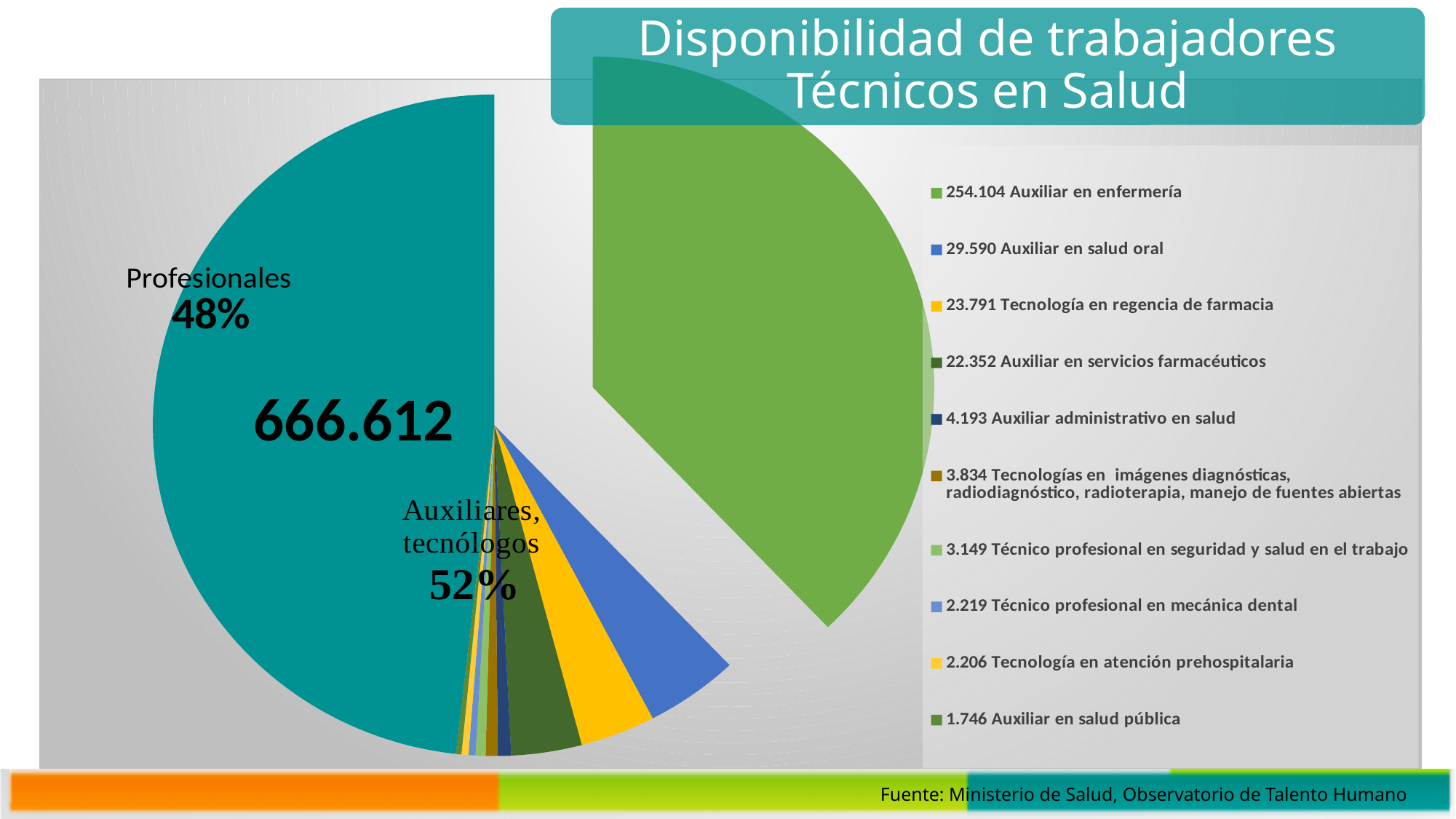
What total figure is printed in the centre of the pie chart? 666.612 How many categories does the legend list? 10 What value is listed in the legend for Auxiliar administrativo en salud? 4.193 What percentage of the pie is labelled Profesionales? 48% Which legend category has the highest value? Auxiliar en enfermería What value is listed in the legend for Auxiliar en salud oral? 29.590 What percentage of the pie is labelled Auxiliares, tecnólogos? 52% What is the difference between the values for Auxiliar en enfermería and Auxiliar en salud oral? 224.514 What kind of chart is shown on the slide? pie chart What is the title of the chart? Disponibilidad de trabajadores Técnicos en Salud What value is listed in the legend for Auxiliar en enfermería? 254.104 Which legend category has the lowest value? Auxiliar en salud pública